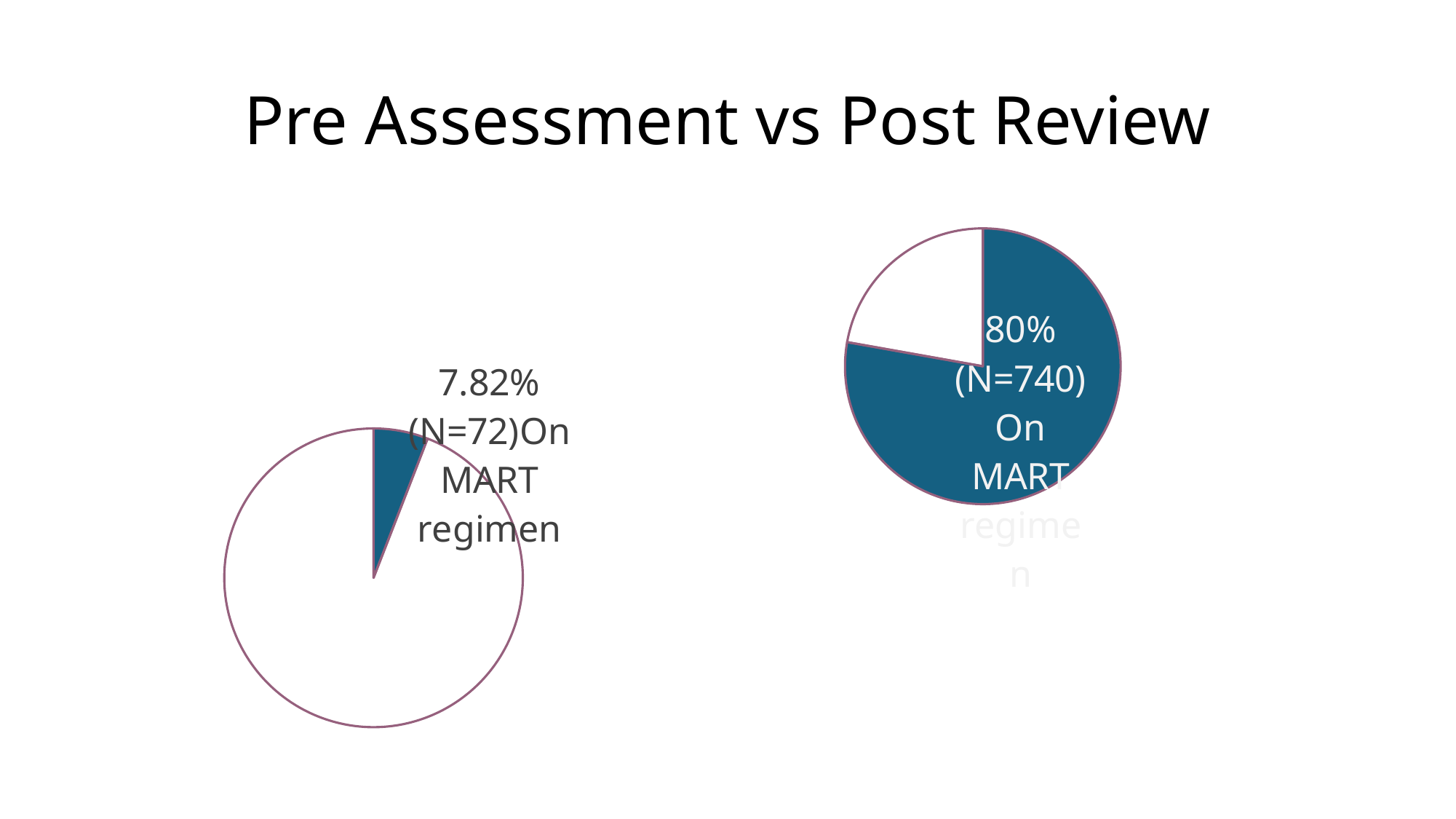
In the right pie chart, what is the N value given for the On MART regimen slice? N=740 Which pie chart shows the larger share On MART regimen, the left or the right? Right In the left pie chart, what percentage is labelled as On MART regimen? 7.82% In the left pie chart, is the On MART regimen slice greater or less than half of the pie? less In the left pie chart, what is the N value given for the On MART regimen slice? N=72 What is the difference in percentage points between the On MART regimen share in the right pie chart and the left pie chart? 72.18 What is the difference between the N values for On MART regimen in the right and left pie charts? 668 In the right pie chart, is the On MART regimen slice greater or less than half of the pie? greater How many pie charts are on the slide? 2 In the right pie chart, what percentage is labelled as On MART regimen? 80% What kind of charts are shown on the slide? Pie charts What is the title of the slide? Pre Assessment vs Post Review